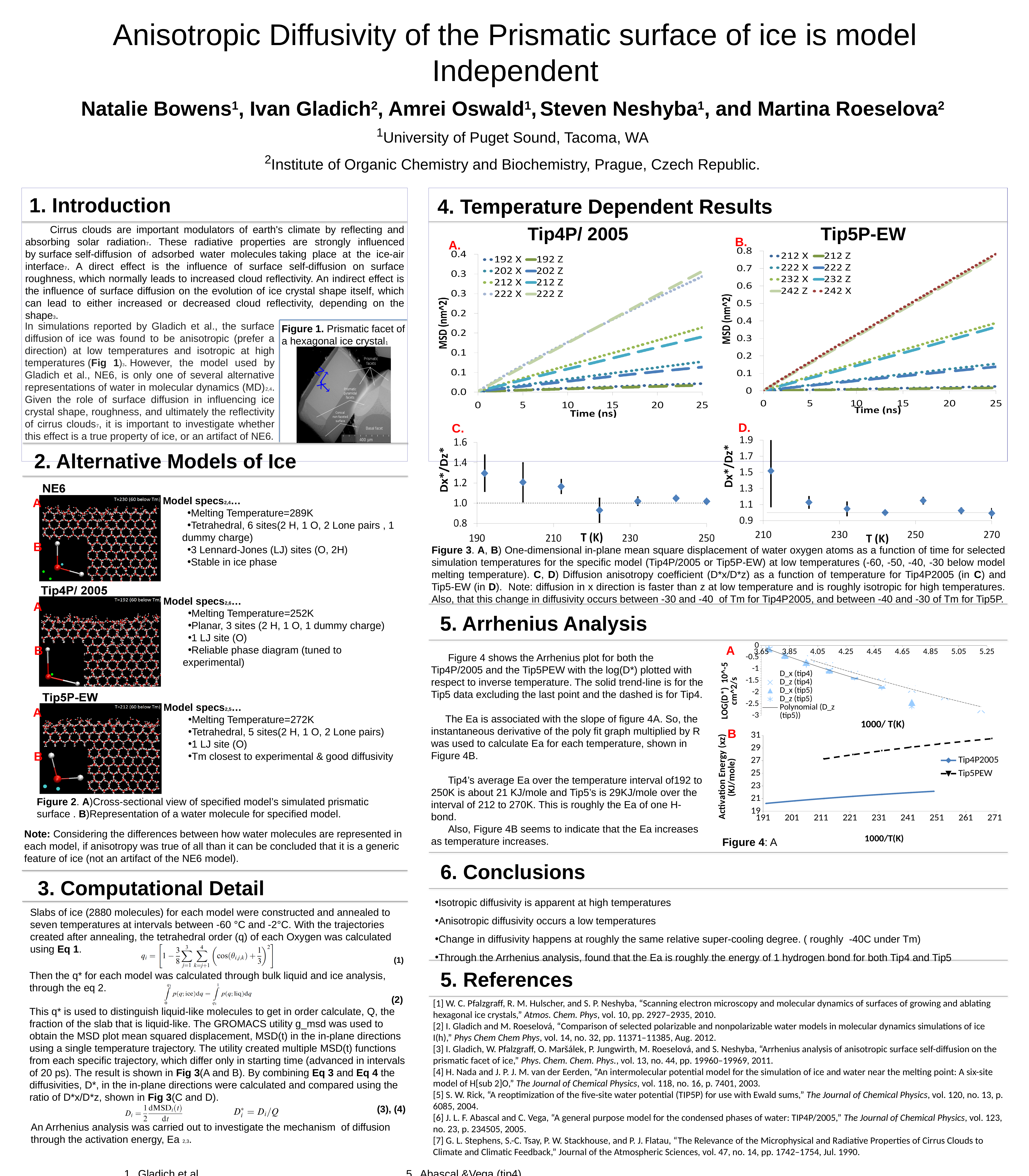
In the Tip4P/2005 chart (Figure 3A), what is the label of the x axis? Time (ns) In Figure 4B (Activation Energy chart), which series has the higher activation energy, Tip4P2005 or Tip5PEW? Tip5PEW In Figure 3D (Dx*/Dz* vs T(K) for Tip5P-EW), is the value at the lowest temperature (about 212 K) greater or less than 1.3? greater In Figure 4B (Activation Energy chart), does the Tip4P2005 activation energy rise or fall as temperature increases? rise In the Tip4P/2005 chart (Figure 3A), do the MSD values rise or fall as time increases? rise In the Tip5P-EW chart (Figure 3B), is the value of the 242 X series at 25 ns greater or less than 0.5? greater In Figure 3C, is the Dx*/Dz* value at the lowest temperature (about 192 K) greater or less than 1.0? greater In Figure 4A (the Arrhenius plot), how many entries does the legend list? 5 In Figure 3C (Dx*/Dz* vs T(K) for Tip4P2005), how many data points are plotted? 7 In the Tip4P/2005 chart (Figure 3A), how many series does the legend list? 8 In the Tip5P-EW chart (Figure 3B), how many series does the legend list? 8